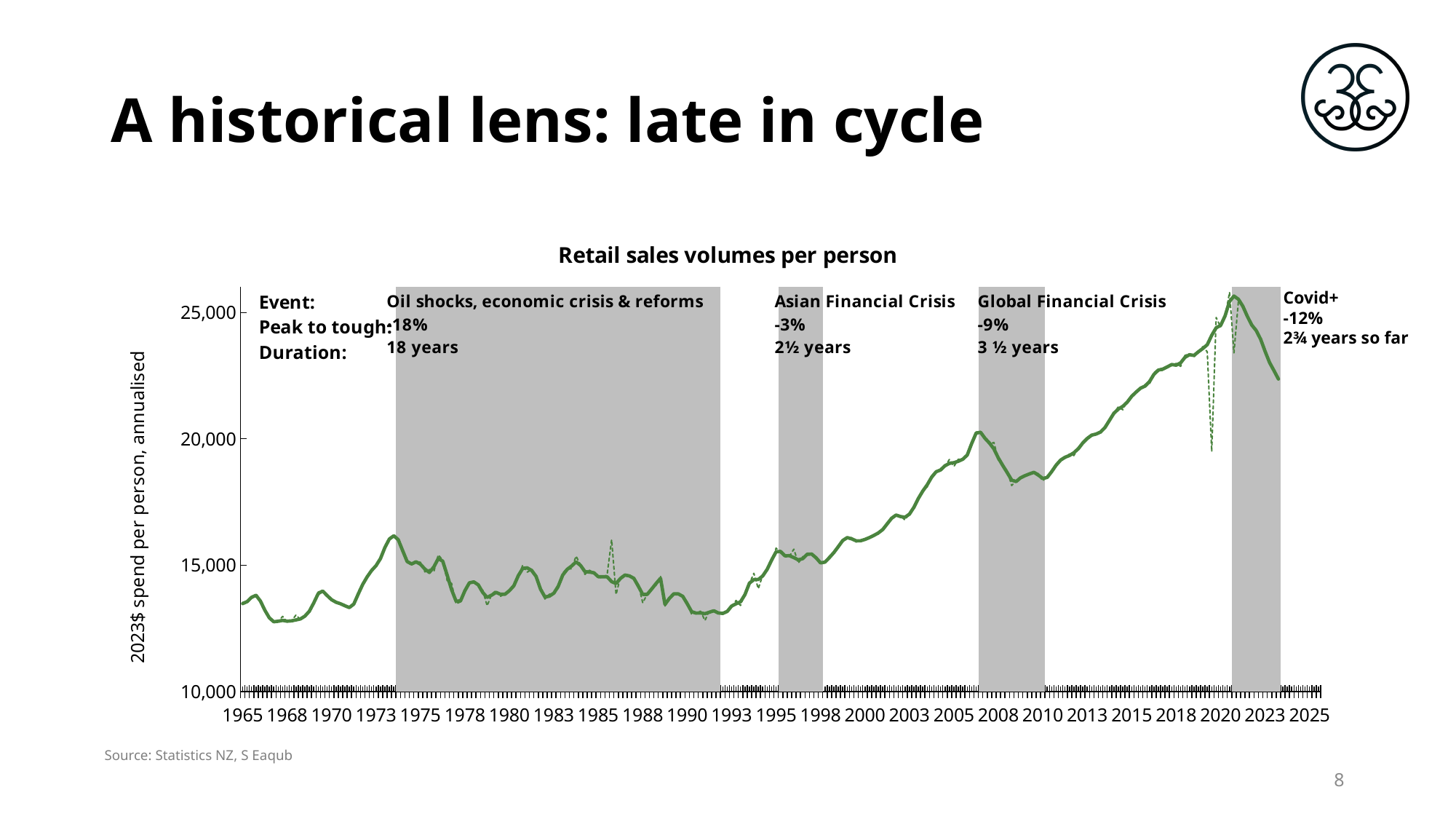
Is the value for 1965 greater or less than 15,000? less What is the y-axis label of the chart? 2023$ spend per person, annualised Which event has the smallest peak to trough decline? Asian Financial Crisis Which event had a larger peak to trough decline, the Global Financial Crisis or the Asian Financial Crisis? Global Financial Crisis What duration is shown for the Asian Financial Crisis? 2½ years What type of chart is shown on the slide? Line chart Which event has the largest peak to trough decline? Oil shocks, economic crisis & reforms How many shaded event periods are marked on the chart? 4 What is the peak to trough decline shown for the Global Financial Crisis? -9% What is the title of the chart? Retail sales volumes per person What duration is shown for the Oil shocks, economic crisis & reforms event? 18 years